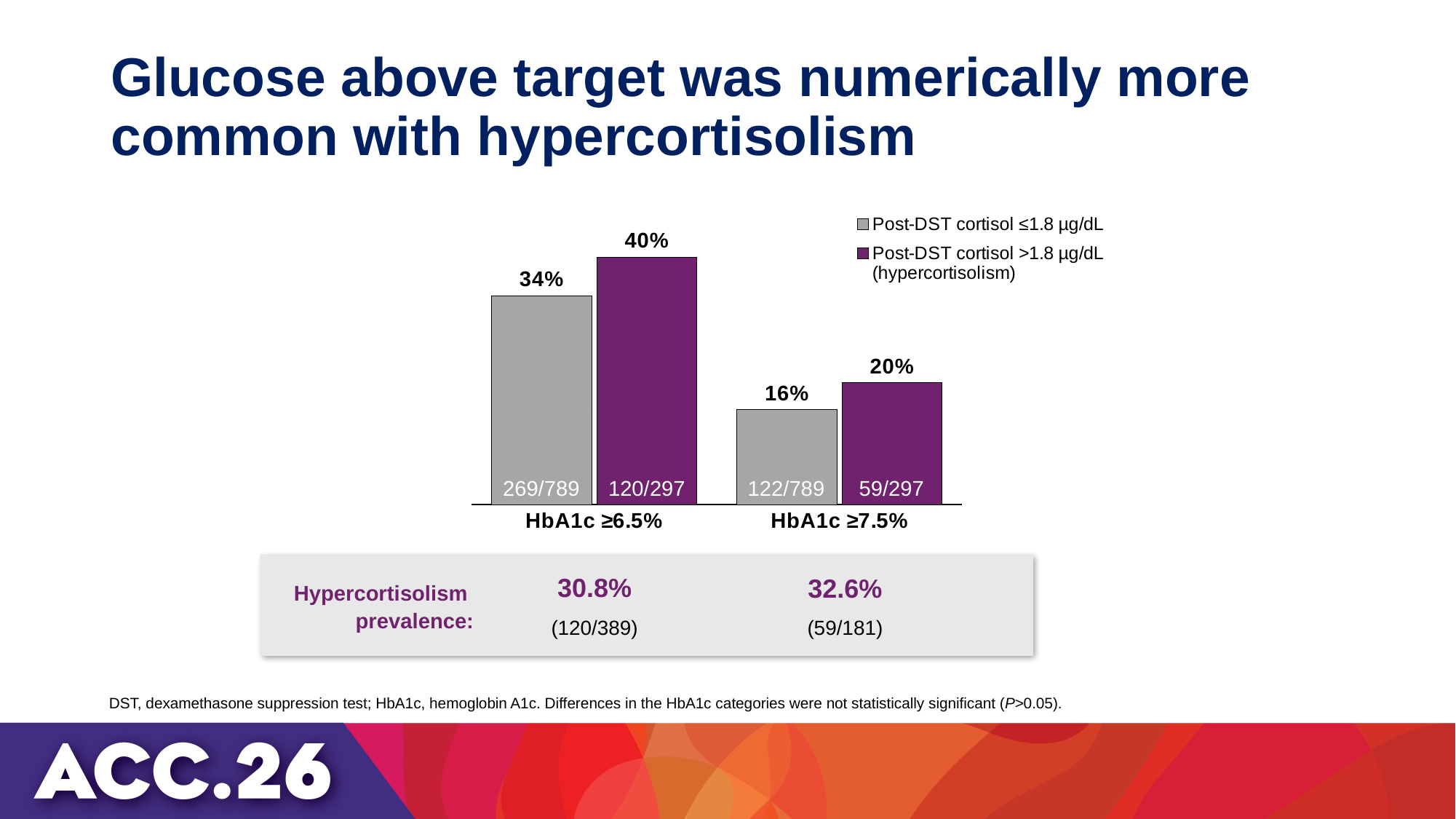
Which bar has the lowest value on the chart? Post-DST cortisol ≤1.8 µg/dL, HbA1c ≥7.5% In the HbA1c ≥7.5% category, which group has the larger value: Post-DST cortisol ≤1.8 µg/dL or hypercortisolism? Hypercortisolism How many HbA1c categories are shown on the x axis? 2 What type of chart is shown on the slide? Bar chart How many series does the legend list? 2 What fraction is printed inside the hypercortisolism bar for HbA1c ≥7.5%? 59/297 What is the difference in percentage points between the hypercortisolism and ≤1.8 µg/dL groups in the HbA1c ≥7.5% category? 4 percentage points What fraction is printed inside the Post-DST cortisol ≤1.8 µg/dL bar for HbA1c ≥6.5%? 269/789 What percentage is shown for Post-DST cortisol ≤1.8 µg/dL in the HbA1c ≥7.5% category? 16% Which bar has the highest value on the chart? Post-DST cortisol >1.8 µg/dL (hypercortisolism), HbA1c ≥6.5% What percentage is shown for Post-DST cortisol >1.8 µg/dL (hypercortisolism) in the HbA1c ≥6.5% category? 40% What is the difference in percentage points between the hypercortisolism and ≤1.8 µg/dL groups in the HbA1c ≥6.5% category? 6 percentage points